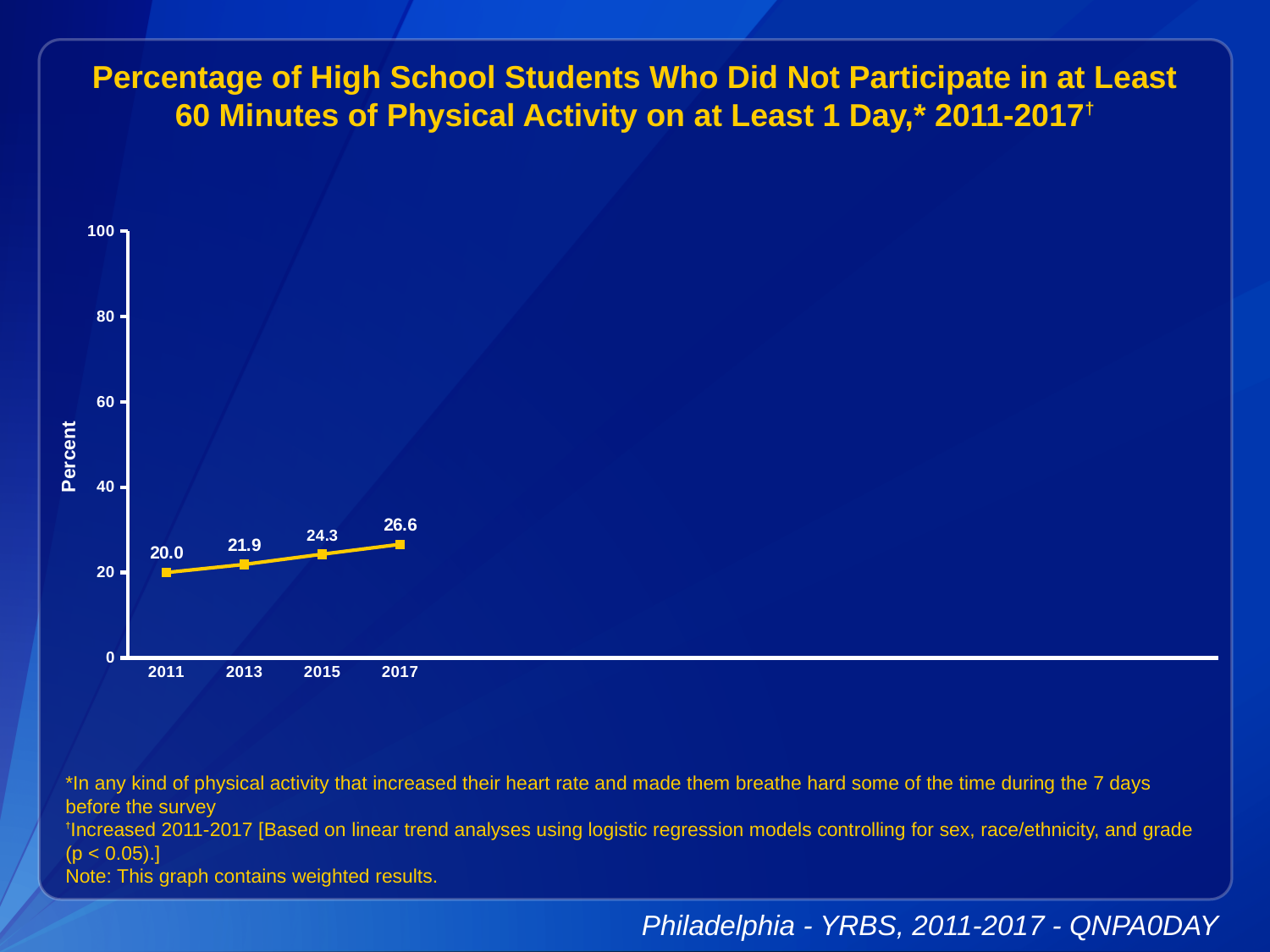
What is the value for 2013? 21.9 What is the value for 2015? 24.3 How many years are plotted on the chart? 4 What is the value for 2017? 26.6 Which is larger, the value for 2013 or the value for 2015? 2015 What kind of chart is shown? line chart What is the difference between the values for 2017 and 2011? 6.6 Do the values rise or fall from 2011 to 2017? rise Which year has the lowest value? 2011 Which year has the highest value? 2017 What is the value for 2011? 20.0 Is the value for 2017 greater or less than 40? less